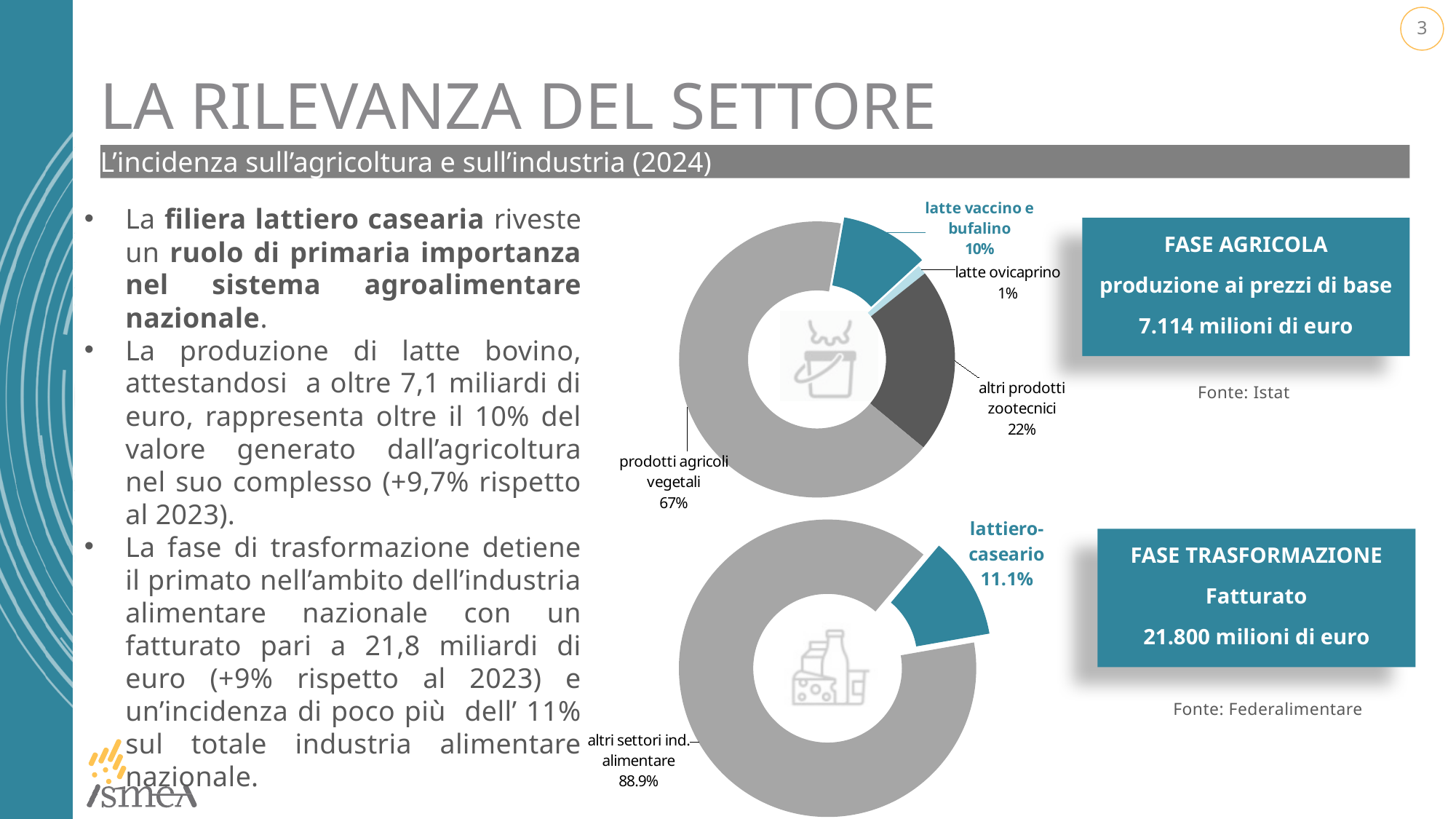
What kind of chart is the bottom chart on the slide? doughnut chart In the top doughnut chart, which category has the smallest share? latte ovicaprino In the top doughnut chart, what is the difference in percentage points between 'altri prodotti zootecnici' and 'latte vaccino e bufalino'? 12 In the top doughnut chart, which category has the largest share? prodotti agricoli vegetali In the top doughnut chart, what share is shown for 'latte vaccino e bufalino'? 10% In the bottom doughnut chart, what share is shown for 'lattiero-caseario'? 11.1% In the bottom doughnut chart, how many categories are shown? 2 In the top doughnut chart, what share is shown for 'prodotti agricoli vegetali'? 67% In the bottom doughnut chart, what share is shown for 'altri settori ind. alimentare'? 88.9% In the top doughnut chart, what share is shown for 'altri prodotti zootecnici'? 22% In the top doughnut chart, which is larger: 'altri prodotti zootecnici' or 'latte vaccino e bufalino'? altri prodotti zootecnici In the top doughnut chart, how many categories are shown? 4